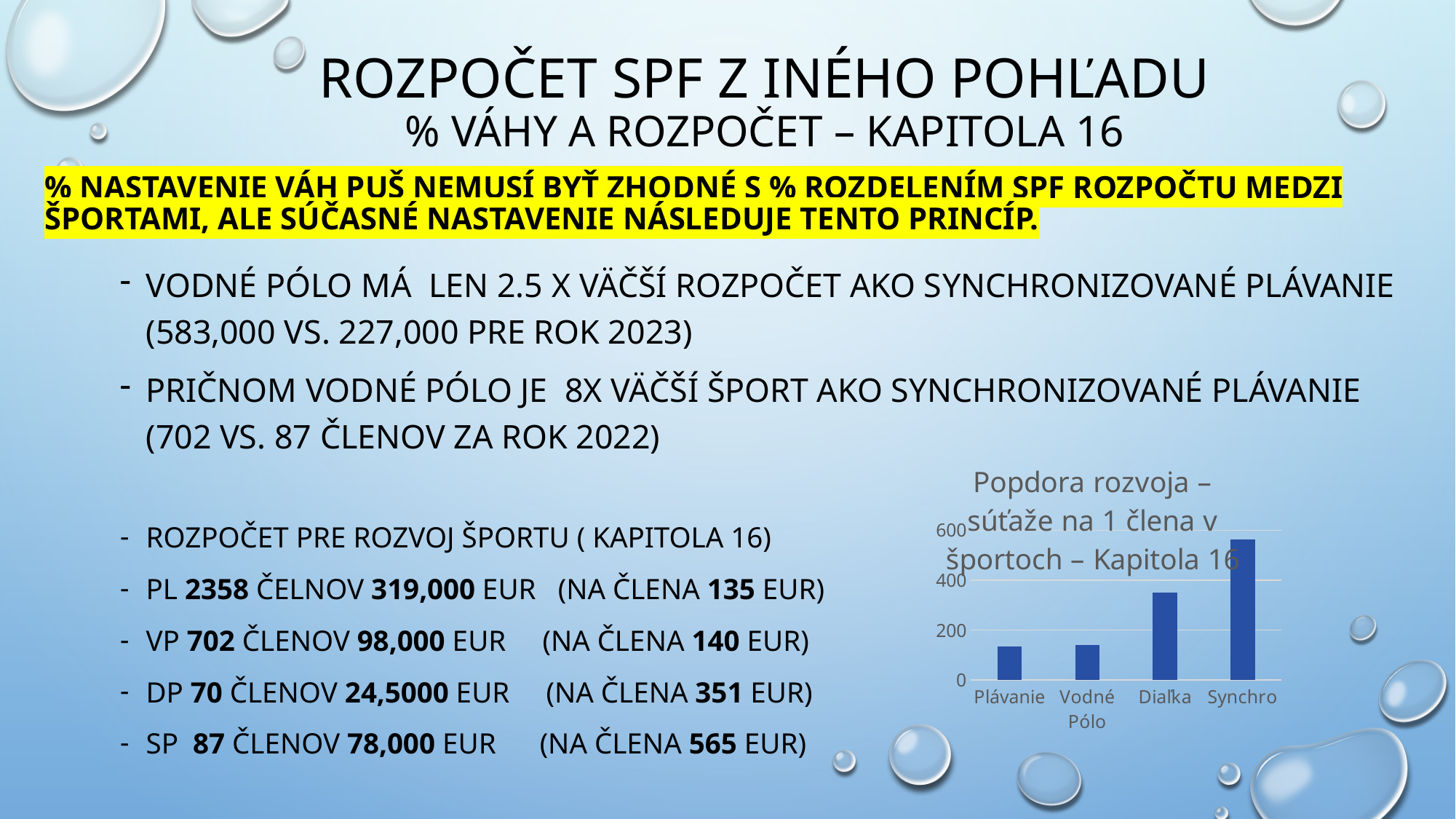
What kind of chart is shown on the slide? bar chart What is the title of the chart? Popdora rozvoja – súťaže na 1 člena v športoch – Kapitola 16 Is the value for Synchro greater or less than 400? greater Is the value for Synchro greater or less than 600? less Is the value for Plávanie greater or less than 200? less Do the values generally rise or fall from left to right along the x axis? rise Which is larger, the value for Synchro or the value for Diaľka? Synchro Which category has the highest bar in the chart? Synchro How many categories are plotted in the chart? 4